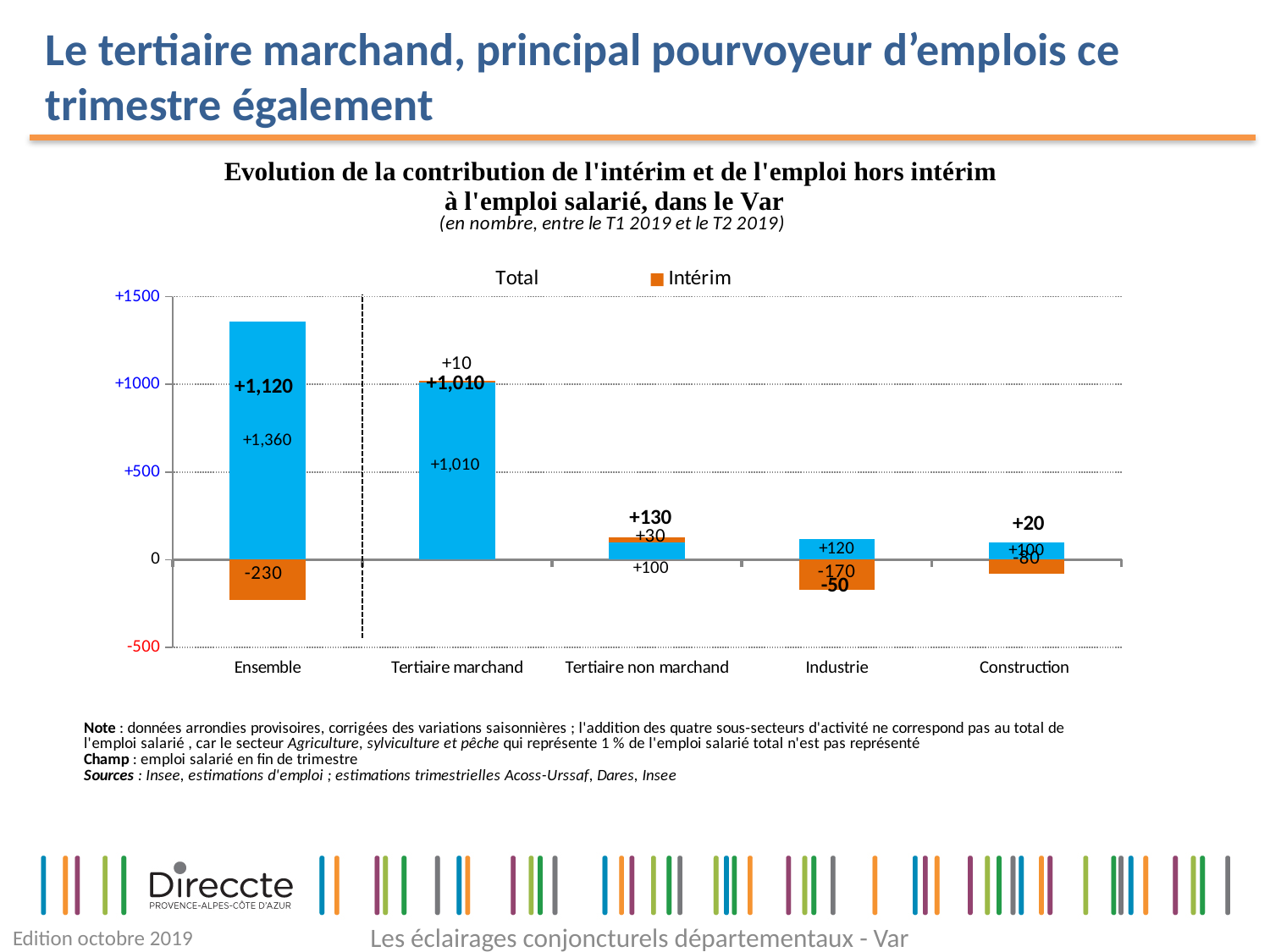
How many sector categories are shown on the x axis of the chart? 5 What is the difference between the blue bar values for Ensemble (+1,360) and Tertiaire marchand (+1,010)? 350 What is the value of the blue bar for Ensemble? +1,360 Which category has the lowest total (bold label)? Industrie Which has the larger Intérim value, Tertiaire marchand or Tertiaire non marchand? Tertiaire non marchand What is the total (bold label) for Industrie? -50 What is the Intérim value for Industrie? -170 What kind of chart is shown on the slide? bar chart Among the four sub-sectors (excluding Ensemble), which has the highest total? Tertiaire marchand Is the Intérim value for Construction greater or less than 0? less What is the total (bold label) for Construction? +20 What is the Intérim value for Ensemble? -230